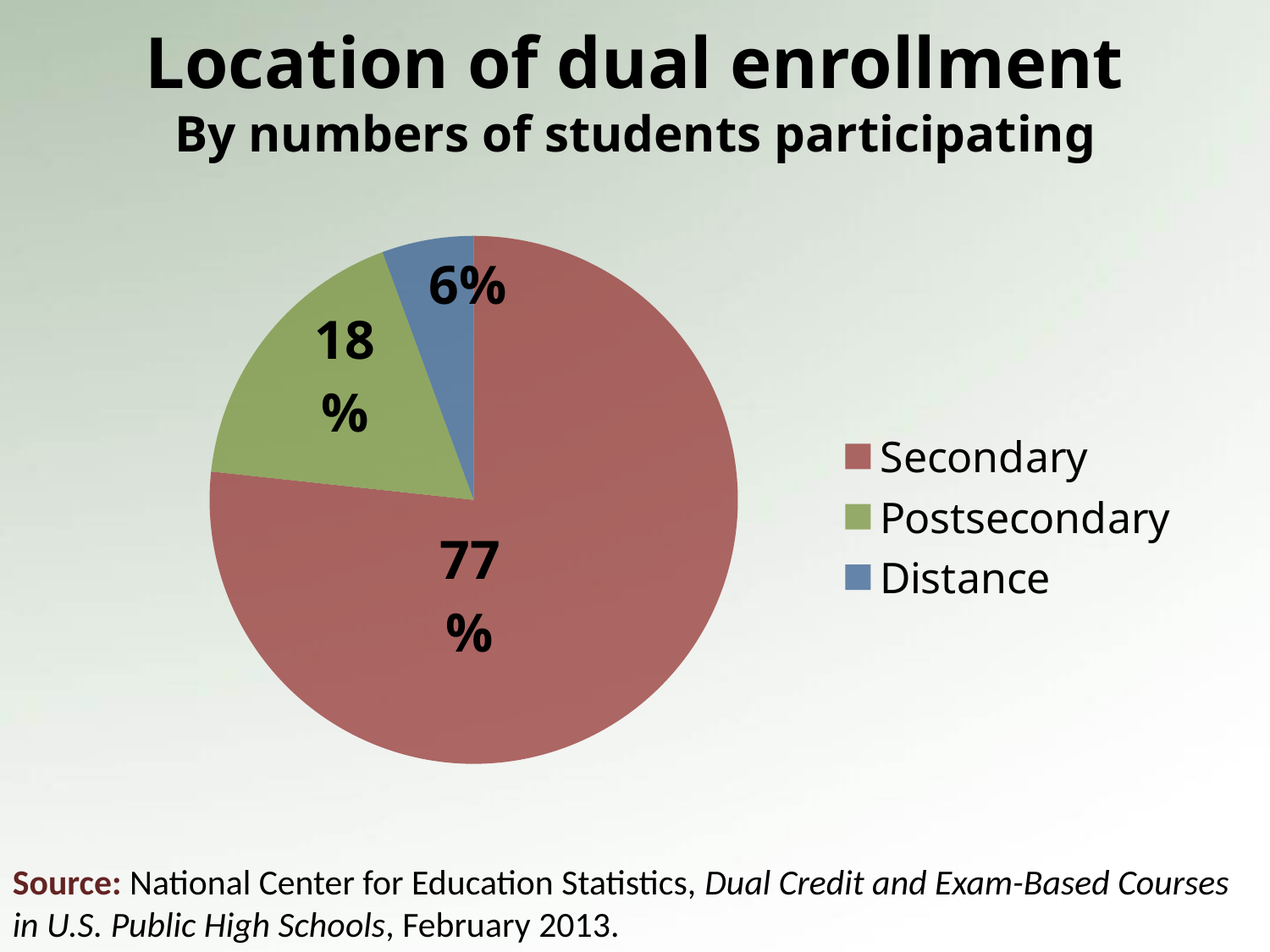
What share of the pie does Distance account for? 6% What share of the pie does Postsecondary account for? 18% How many categories are shown in the pie chart? 3 Which is larger, the Postsecondary slice or the Distance slice? Postsecondary What kind of chart is shown on the slide? Pie chart What is the difference in percentage points between the Postsecondary and Distance slices? 12 Which category has the largest slice of the pie? Secondary What share of the pie does Secondary account for? 77% What is the title of the chart? Location of dual enrollment What colour is the Distance slice in the pie chart? Blue Which category has the smallest slice of the pie? Distance What is the difference in percentage points between the Secondary and Postsecondary slices? 59